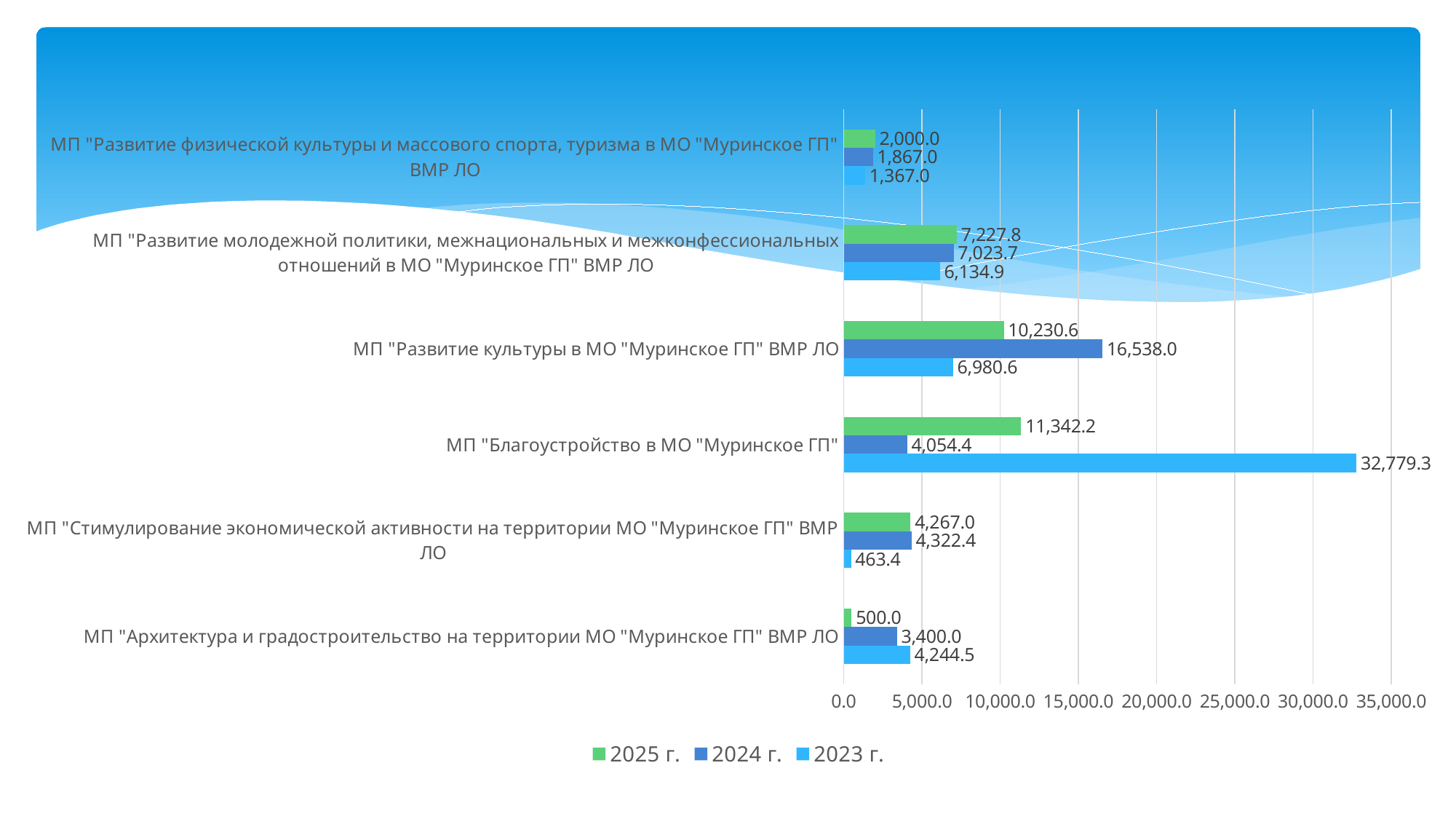
What is the 2023 г. value for МП "Благоустройство в МО "Муринское ГП""? 32,779.3 Which category has the highest 2023 г. value? МП "Благоустройство в МО "Муринское ГП"" For МП "Развитие культуры в МО "Муринское ГП" ВМР ЛО", which year has the larger value, 2024 г. or 2023 г.? 2024 г. What is the difference between the 2024 г. and 2025 г. values for МП "Развитие культуры в МО "Муринское ГП" ВМР ЛО"? 6,307.4 Which category has the lowest 2025 г. value? МП "Архитектура и градостроительство на территории МО "Муринское ГП" ВМР ЛО" How many series does the legend list? 3 What is the 2024 г. value for МП "Развитие культуры в МО "Муринское ГП" ВМР ЛО"? 16,538.0 Is the 2023 г. value for МП "Благоустройство в МО "Муринское ГП"" greater or less than 30,000.0? greater How many categories are shown on the chart? 6 What is the difference between the 2023 г. and 2024 г. values for МП "Благоустройство в МО "Муринское ГП""? 28,724.9 What is the 2025 г. value for МП "Архитектура и градостроительство на территории МО "Муринское ГП" ВМР ЛО"? 500.0 Which category has the lowest 2023 г. value? МП "Стимулирование экономической активности на территории МО "Муринское ГП" ВМР ЛО"